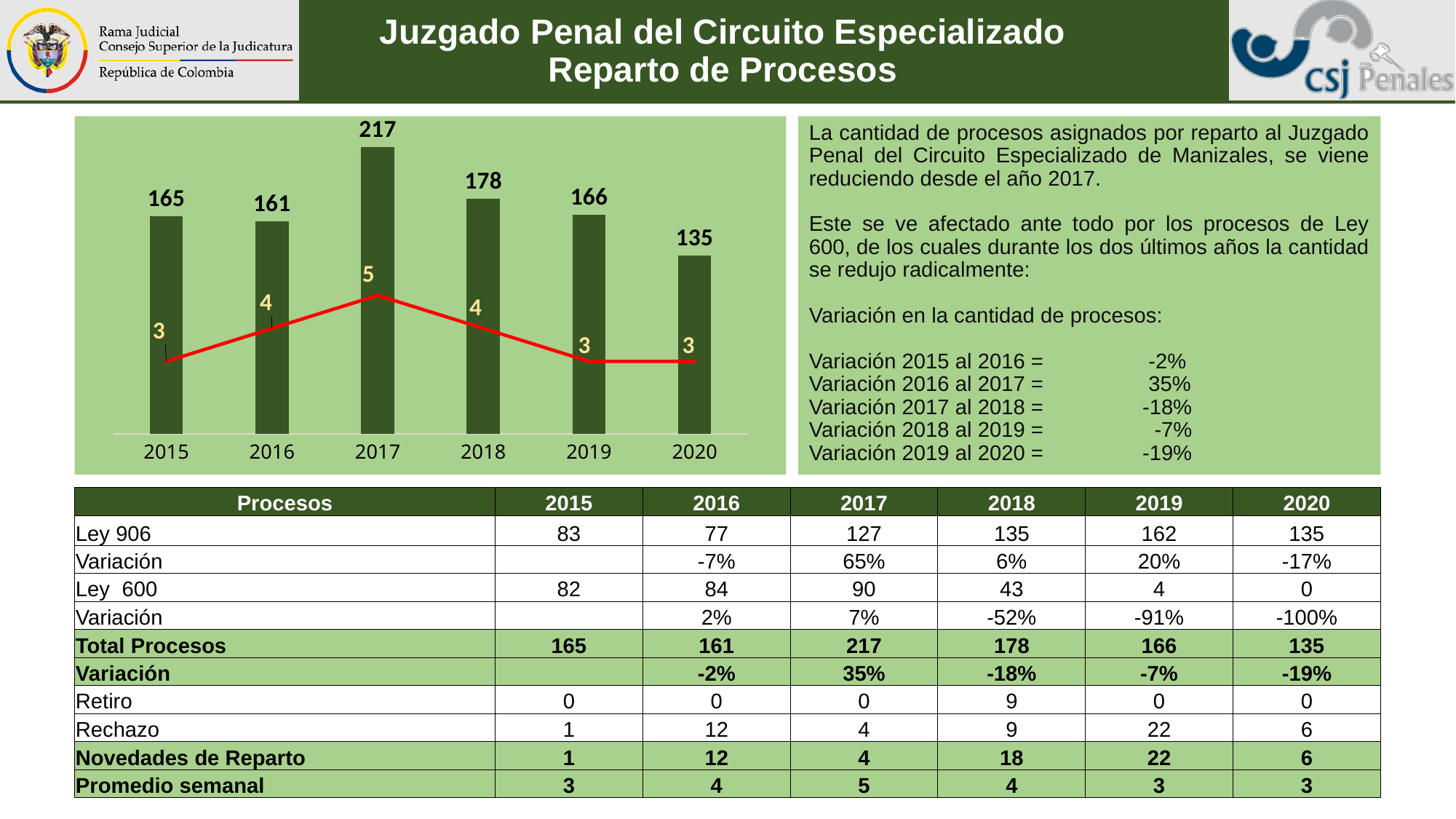
What value does the red line show for 2017? 5 What is the difference between the bar values for 2017 and 2018? 39 What is the difference between the bar values for 2015 and 2020? 30 Which year has the highest bar? 2017 What kind of chart is shown on the slide? Combined bar and line chart Which bar is taller, 2018 or 2019? 2018 What is the value of the bar for 2020? 135 Do the bar values rise or fall from 2017 to 2020? Fall How many years are shown on the x axis of the chart? 6 Which year has the lowest bar? 2020 What colour is the line plotted over the bars? Red What is the value of the bar for 2017? 217